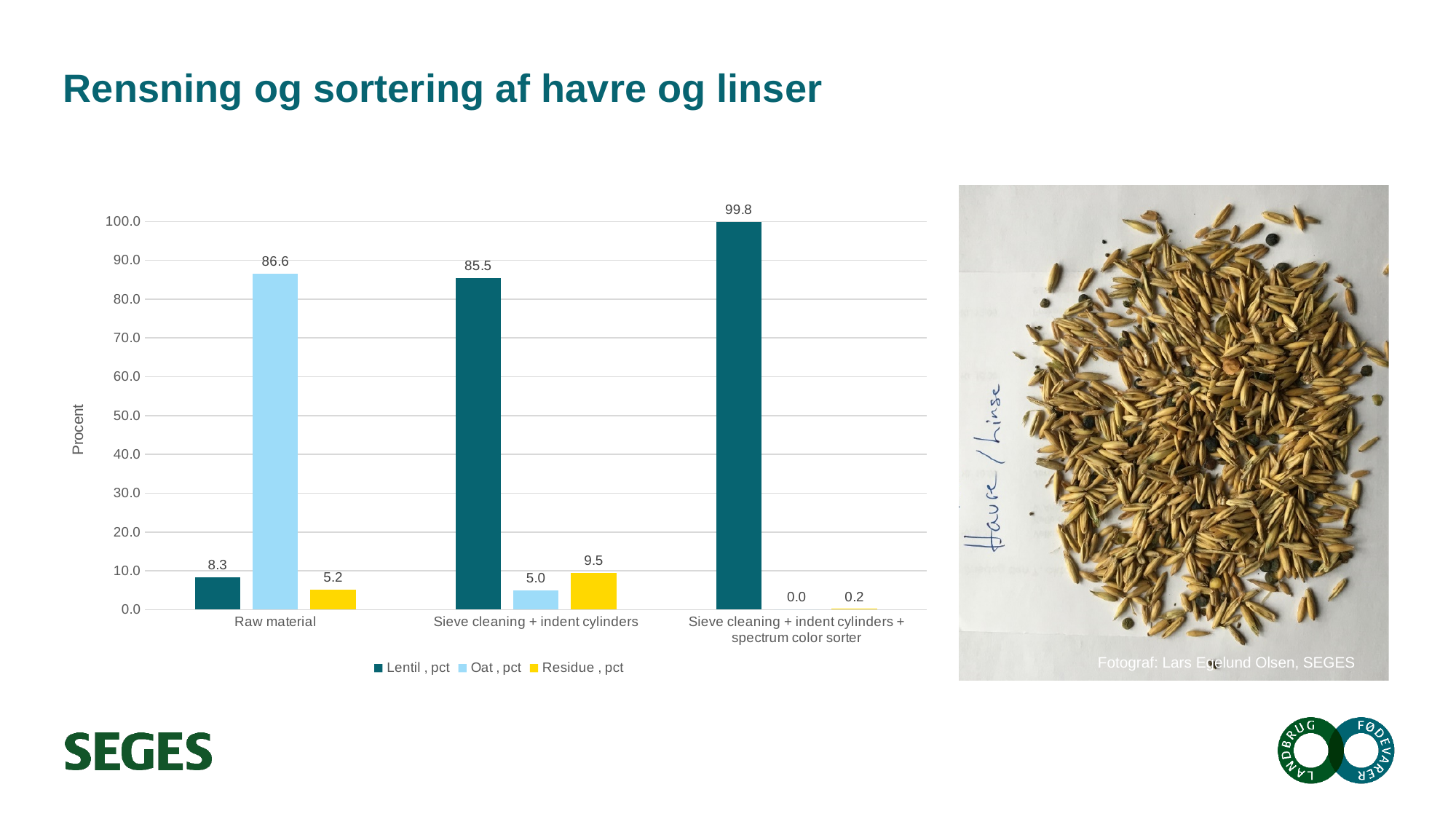
Which category has the highest Lentil, pct value? Sieve cleaning + indent cylinders + spectrum color sorter What is the Lentil, pct value for Sieve cleaning + indent cylinders + spectrum color sorter? 99.8 What is the Lentil, pct value for Raw material? 8.3 How many series does the legend list? 3 Which category has the lowest Oat, pct value? Sieve cleaning + indent cylinders + spectrum color sorter How many categories are shown on the x axis? 3 What is the Oat, pct value for Raw material? 86.6 Which is larger for Raw material: Oat, pct or Residue, pct? Oat, pct What is the Residue, pct value for Sieve cleaning + indent cylinders? 9.5 What is the difference between the Lentil, pct values for Sieve cleaning + indent cylinders + spectrum color sorter and Raw material? 91.5 What is the Oat, pct value for Sieve cleaning + indent cylinders + spectrum color sorter? 0.0 What kind of chart is shown on the slide? Bar chart